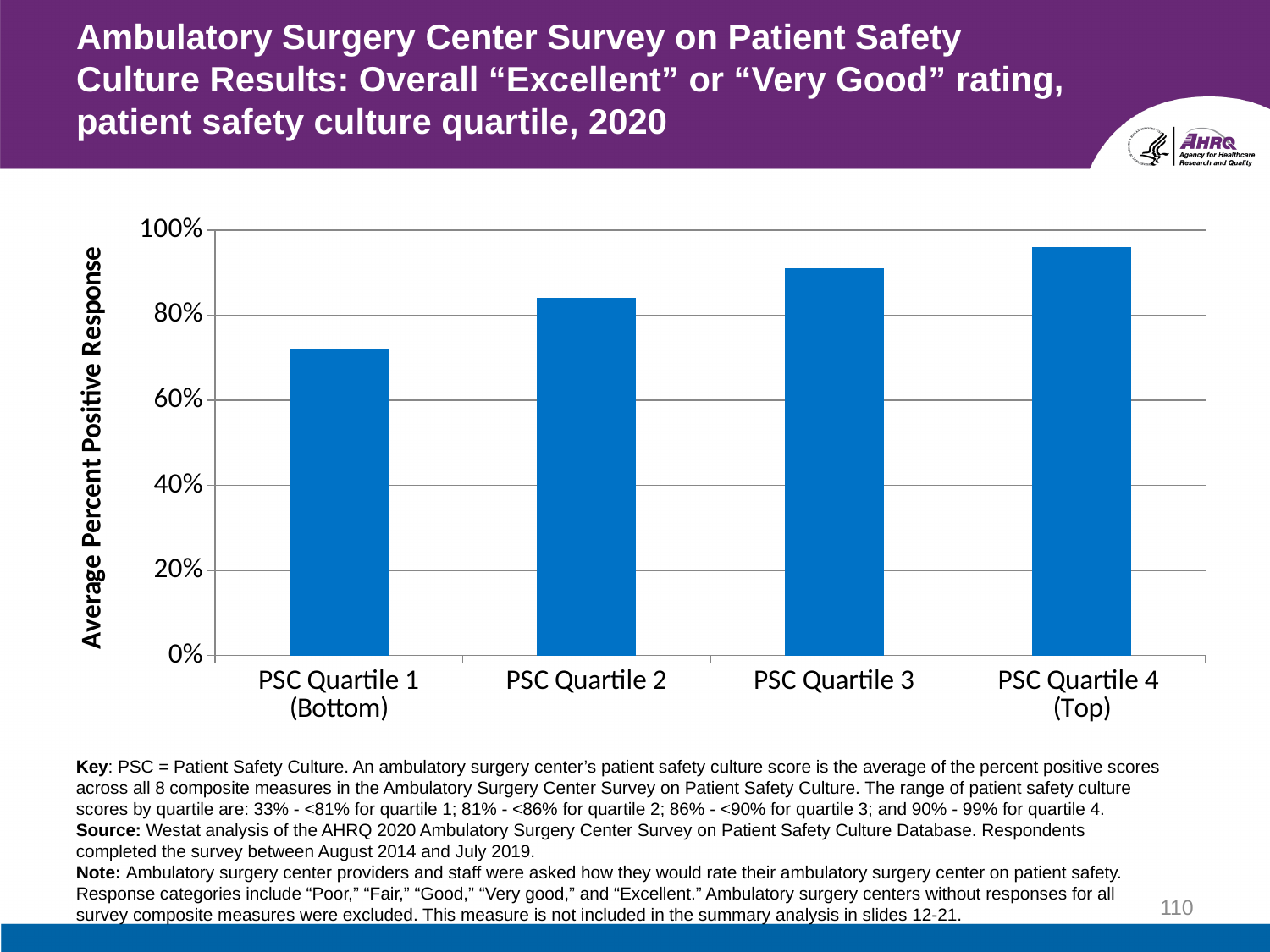
Is the value for PSC Quartile 4 (Top) greater or less than 100%? less Do the values rise or fall from PSC Quartile 1 (Bottom) to PSC Quartile 4 (Top)? rise Which quartile has the highest average percent positive response? PSC Quartile 4 (Top) Which has a larger value, PSC Quartile 2 or PSC Quartile 3? PSC Quartile 3 Which quartile has the lowest average percent positive response? PSC Quartile 1 (Bottom) Is the value for PSC Quartile 2 greater or less than 80%? greater Is the value for PSC Quartile 1 (Bottom) greater or less than 80%? less What is the label on the vertical axis of the chart? Average Percent Positive Response How many categories (quartiles) are plotted on the chart? 4 What kind of chart is shown on the slide? bar chart